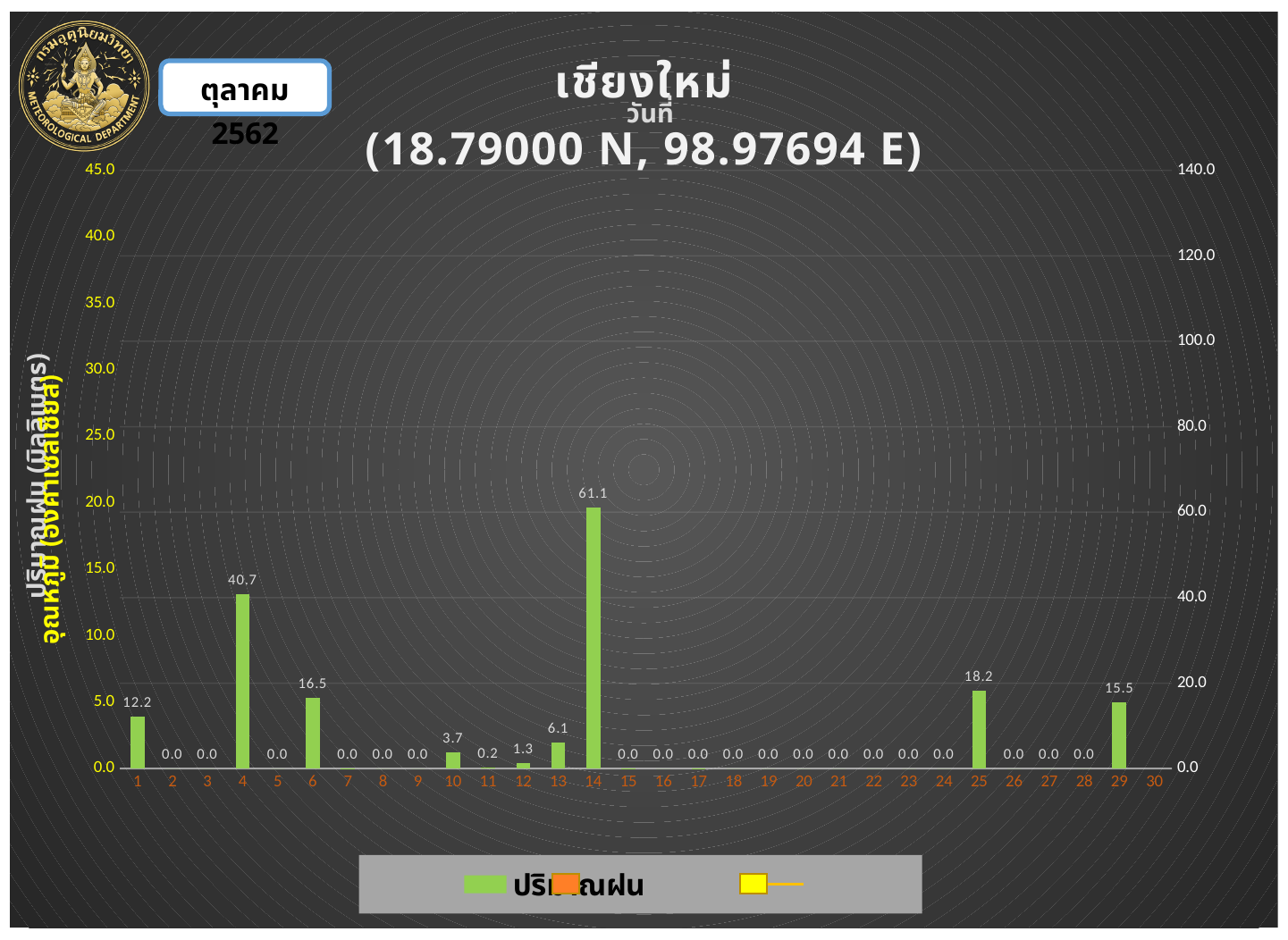
Which is larger, the rainfall value for day 25 or for day 6? day 25 What is the rainfall value shown for day 25? 18.2 What kind of chart is shown on the slide? bar chart What is the rainfall value shown for day 11? 0.2 What is the rainfall value shown for day 14? 61.1 What is the difference between the rainfall values for day 14 and day 4? 20.4 What is the difference between the rainfall values for day 6 and day 29? 1.0 What is the rainfall value shown for day 1? 12.2 What is the rainfall value shown for day 4? 40.7 What is the highest value shown on the right-hand vertical axis? 140.0 Is the rainfall value for day 4 greater or less than 20.0 on the right axis? greater Which day has the highest rainfall value? 14